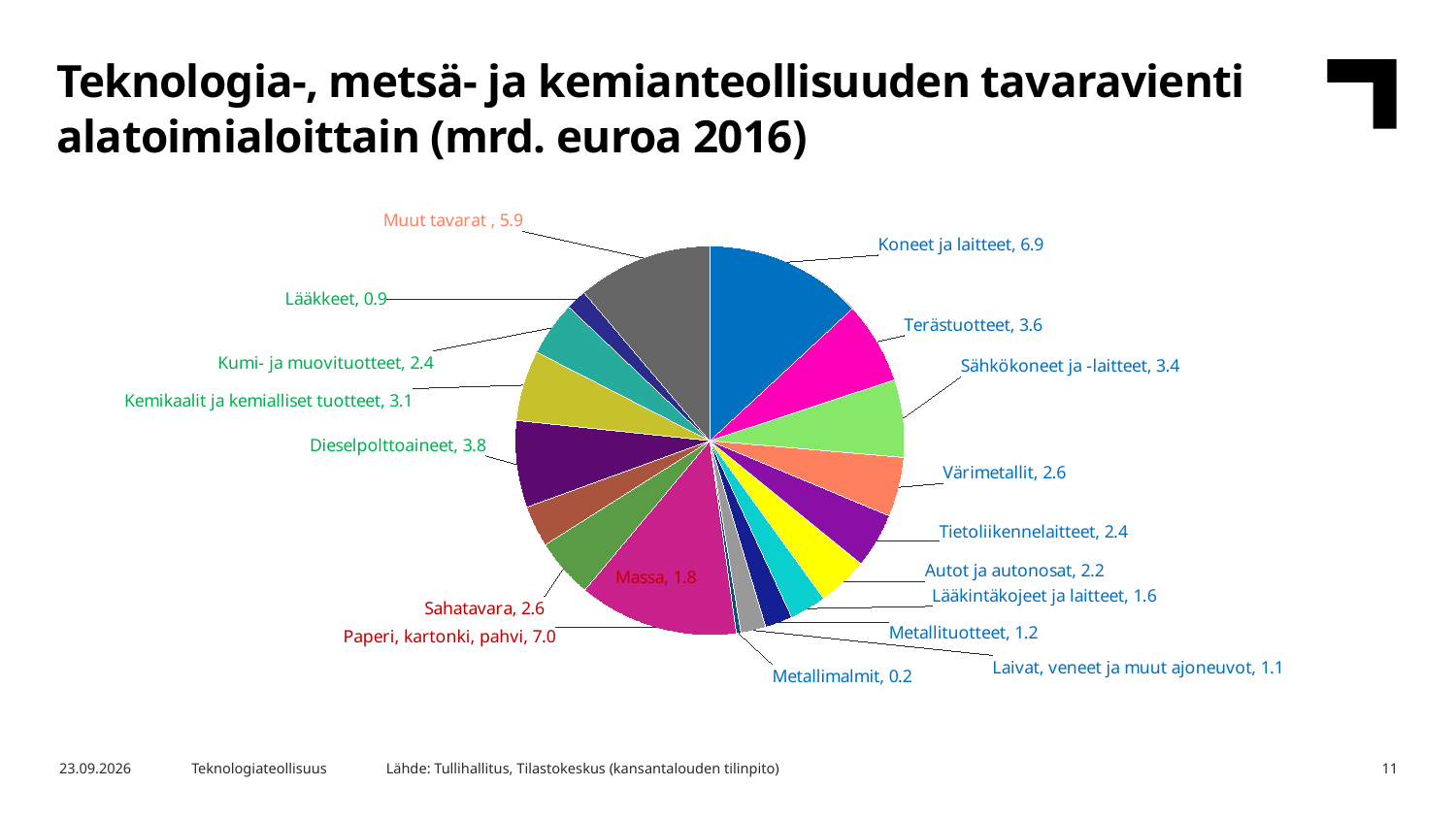
What is the difference between the values for Dieselpolttoaineet and Kemikaalit ja kemialliset tuotteet? 0.7 What is the difference between the values for Koneet ja laitteet and Terästuotteet? 3.3 Which is larger, the value for Terästuotteet or the value for Sähkökoneet ja -laitteet? Terästuotteet Which category has the largest value in the pie chart? Paperi, kartonki, pahvi How many categories are shown in the pie chart? 18 What is the value for Muut tavarat? 5.9 What type of chart is shown on the slide? Pie chart Which category has the smallest value in the pie chart? Metallimalmit What is the value for Koneet ja laitteet? 6.9 What is the value for Dieselpolttoaineet? 3.8 What is the title of the chart on the slide? Teknologia-, metsä- ja kemianteollisuuden tavaravienti alatoimialoittain (mrd. euroa 2016) What is the value for Paperi, kartonki, pahvi? 7.0